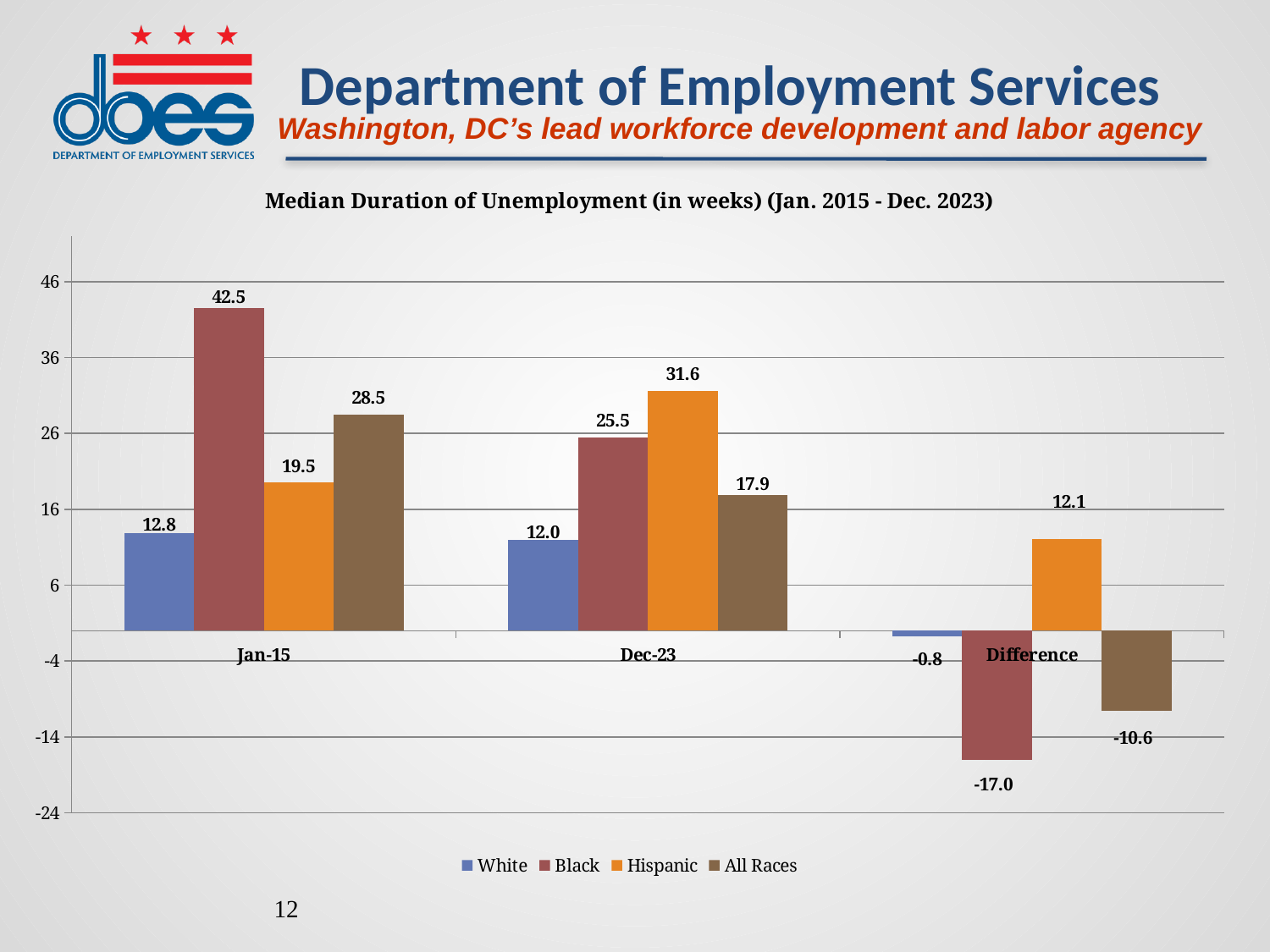
What is the median duration of unemployment for Black workers in Jan-15? 42.5 What is the Difference value for All Races? -10.6 Which is larger in Dec-23, the Hispanic value or the All Races value? Hispanic Which series has the highest value in Jan-15? Black Is the All Races value for Jan-15 greater or less than 26? greater What is the value for Hispanic workers in Dec-23? 31.6 How many series does the legend list? 4 How many categories are shown on the x axis? 3 What is the title of the chart? Median Duration of Unemployment (in weeks) (Jan. 2015 - Dec. 2023) What kind of chart is shown on the slide? Bar chart Which series has the lowest value in Dec-23? White What is the difference between the Black value in Jan-15 and the Black value in Dec-23? 17.0